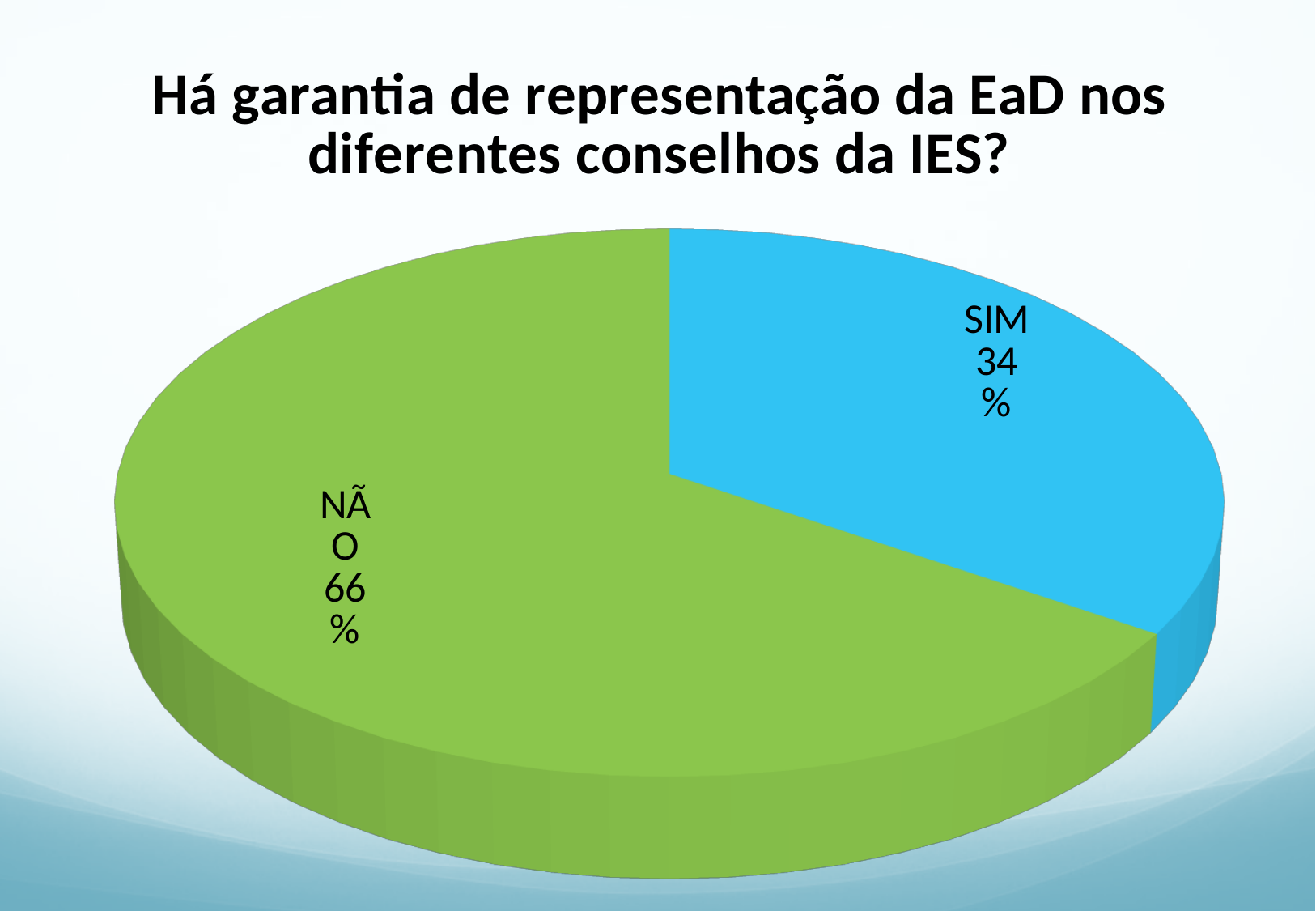
What percentage of the pie chart is labelled NÃO? 66% What share of the pie does the SIM slice represent? 34% What is the difference in percentage points between the NÃO slice and the SIM slice? 32 What percentage of the pie chart is labelled SIM? 34% How many slices does the pie chart have? 2 What colour is the NÃO slice of the pie chart? Green Which slice of the pie chart is the largest? NÃO What is the title of the chart? Há garantia de representação da EaD nos diferentes conselhos da IES? Which slice of the pie chart is the smallest? SIM What kind of chart is shown on the slide? Pie chart Which is larger, the SIM slice or the NÃO slice? NÃO